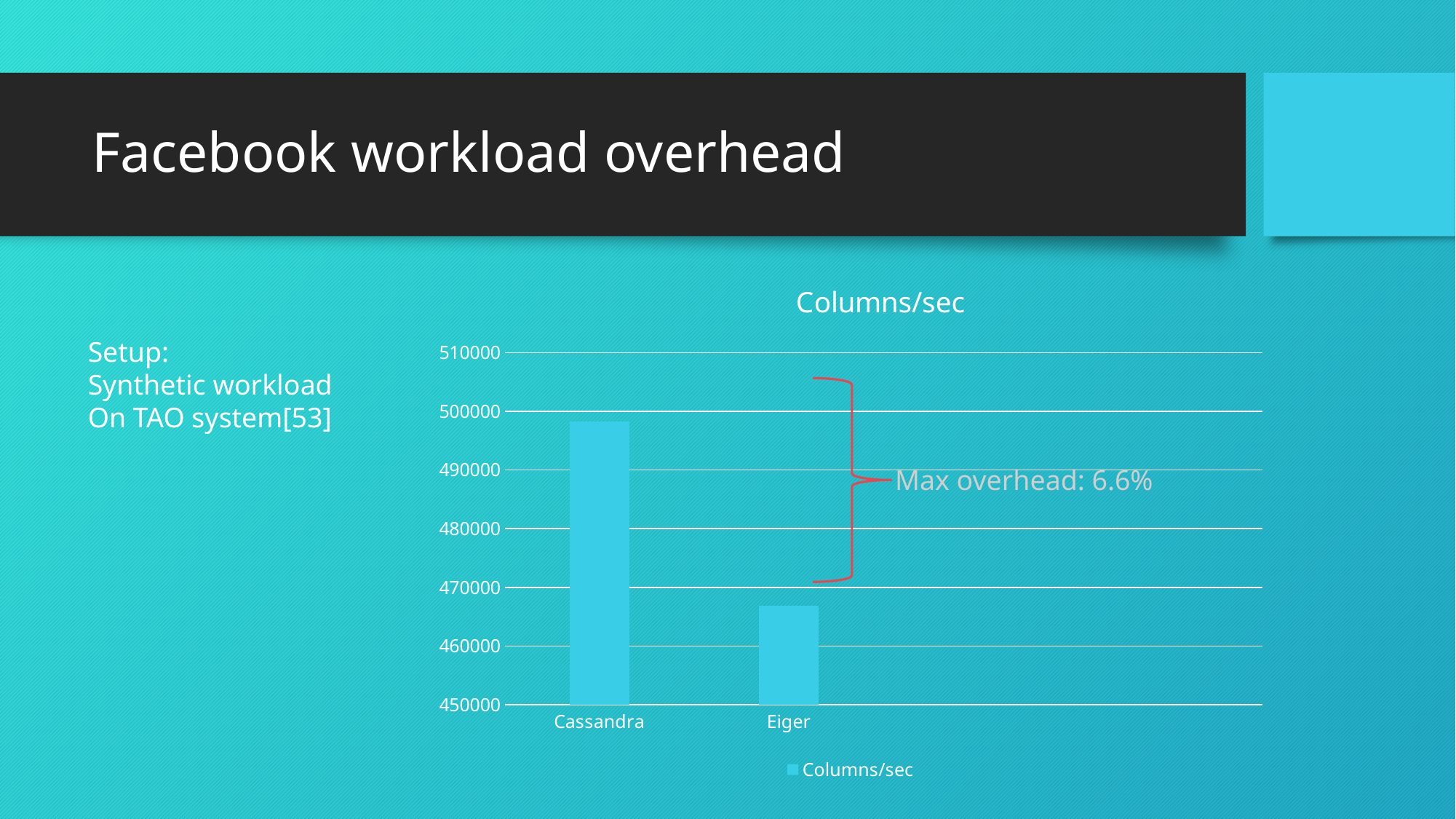
Is the value for Eiger greater or less than 470000? less How many categories are plotted on the x axis? 2 How many series does the legend list? 1 What is the title of the chart? Columns/sec Which category has the lowest value? Eiger What is the name of the series shown in the legend? Columns/sec Do the values rise or fall from Cassandra to Eiger? fall Which is larger, the value for Cassandra or the value for Eiger? Cassandra Is the value for Eiger greater or less than 460000? greater What type of chart is shown on the slide? bar chart Is the value for Cassandra greater or less than 490000? greater Which category has the highest value? Cassandra